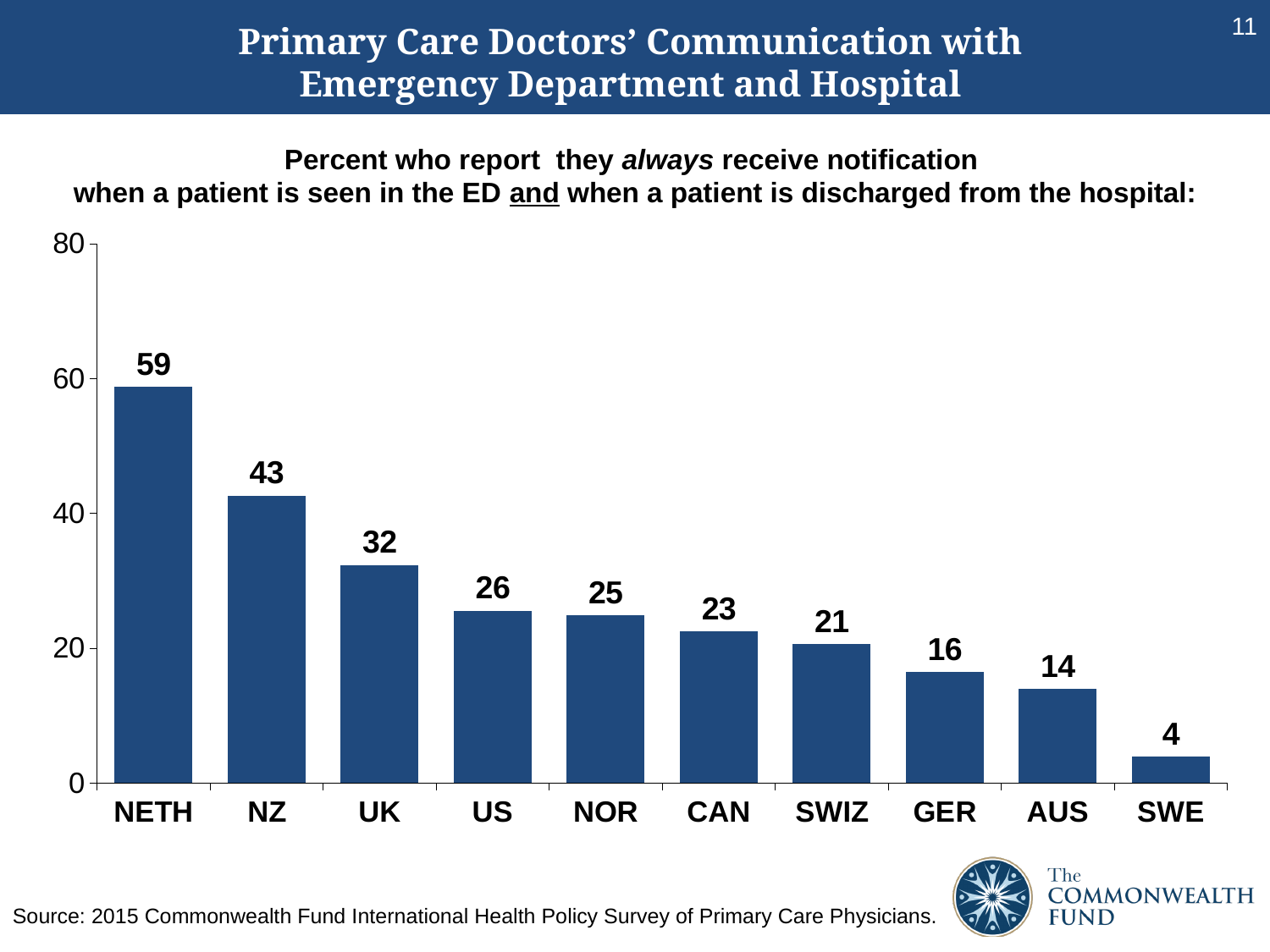
Which country has the highest value? NETH What is the value for GER? 16 What kind of chart is shown on the slide? Bar chart Which is larger, the value for CAN or the value for SWIZ? CAN What is the value for US? 26 What is the difference between the values for UK and AUS? 18 What is the value for NETH? 59 What is the difference between the values for NETH and NZ? 16 Which country has the lowest value? SWE How many countries are shown on the chart? 10 Do the values rise or fall from left to right along the x axis? Fall Is the value for NZ greater or less than 40? greater